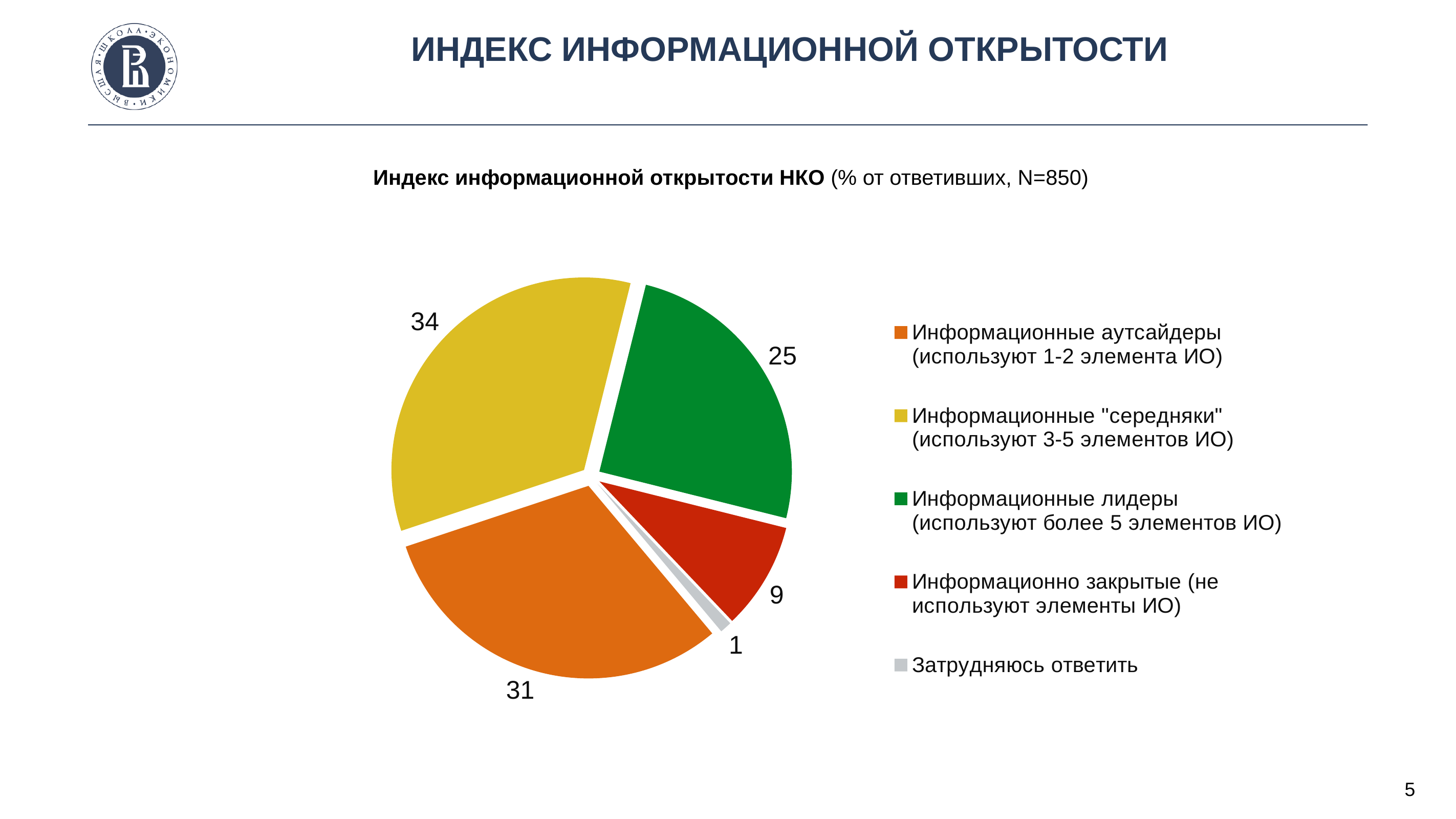
What is the value for Затрудняюсь ответить? 1 What is the value for Информационные аутсайдеры (используют 1-2 элемента ИО)? 31 What is the value for Информационные лидеры (используют более 5 элементов ИО)? 25 What is the value for Информационно закрытые (не используют элементы ИО)? 9 How many categories does the legend list? 5 What is the value for Информационные "середняки" (используют 3-5 элементов ИО)? 34 Which category has the largest share of the pie? Информационные "середняки" (используют 3-5 элементов ИО) Which category has the smallest share of the pie? Затрудняюсь ответить What is the difference between the values for Информационные "середняки" and Информационные лидеры? 9 What kind of chart is shown on the slide? Pie chart What colour is the slice for Информационные лидеры (используют более 5 элементов ИО)? Green Which is larger: the value for Информационные лидеры or the value for Информационно закрытые? Информационные лидеры